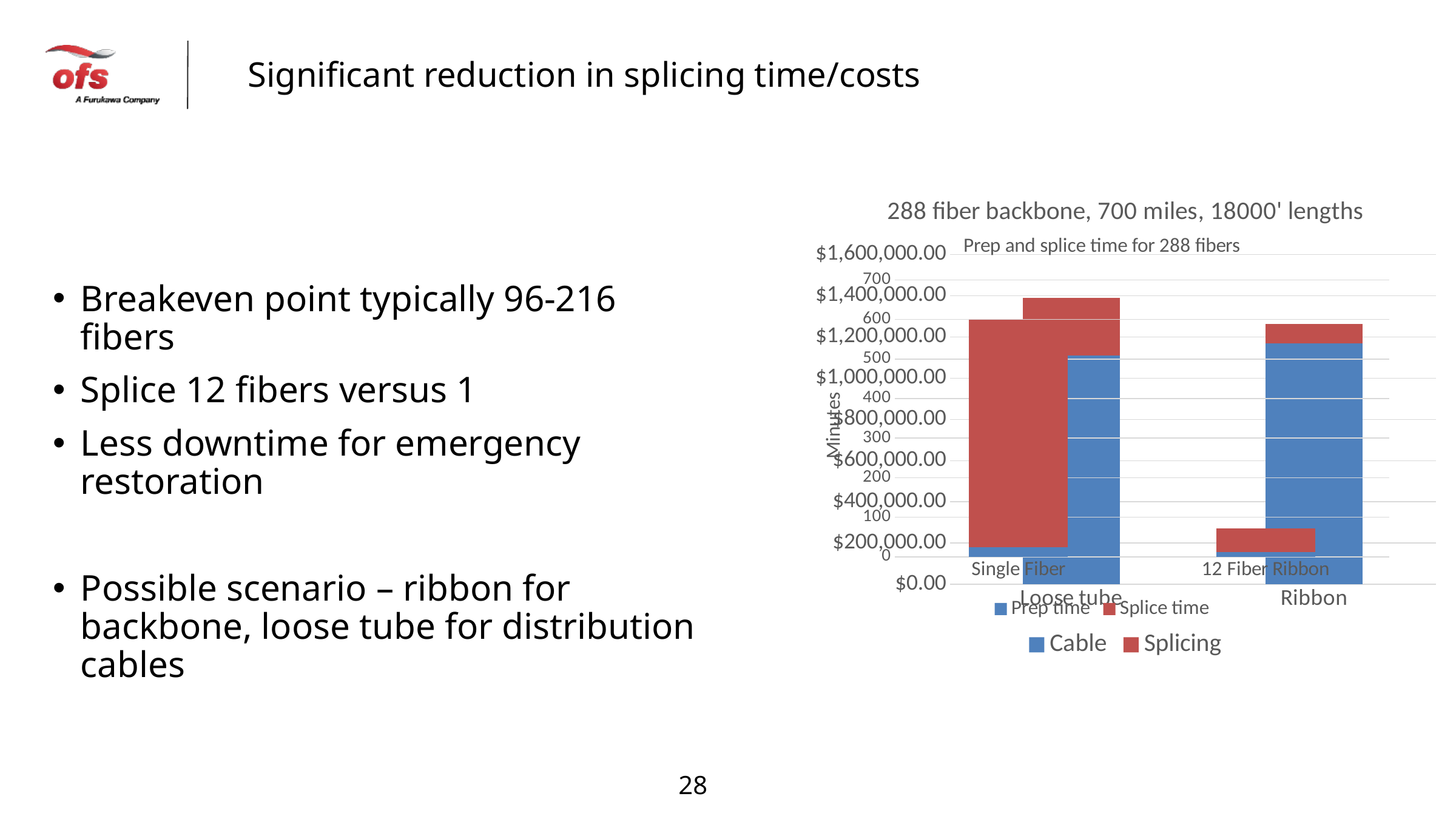
In the chart titled "Prep and splice time for 288 fibers", what is the label of the y axis? Minutes In the chart titled "288 fiber backbone, 700 miles, 18000' lengths", is the total for Ribbon greater or less than $1,000,000.00? greater In the chart titled "288 fiber backbone, 700 miles, 18000' lengths", which category has the larger Splicing segment, Loose tube or Ribbon? Loose tube In the chart titled "288 fiber backbone, 700 miles, 18000' lengths", which category has the taller stacked bar, Loose tube or Ribbon? Loose tube In the chart titled "Prep and splice time for 288 fibers", is the total for 12 Fiber Ribbon greater or less than 100 minutes? less In the chart titled "288 fiber backbone, 700 miles, 18000' lengths", how many categories are shown on the x axis? 2 In the chart titled "Prep and splice time for 288 fibers", which category has the taller stacked bar, Single Fiber or 12 Fiber Ribbon? Single Fiber In the chart titled "288 fiber backbone, 700 miles, 18000' lengths", what series does the legend list? Cable, Splicing In the chart titled "288 fiber backbone, 700 miles, 18000' lengths", is the total for Loose tube greater or less than $1,200,000.00? greater What kind of chart is the one titled "288 fiber backbone, 700 miles, 18000' lengths"? Stacked bar chart In the chart titled "Prep and splice time for 288 fibers", how many series does the legend list? 2